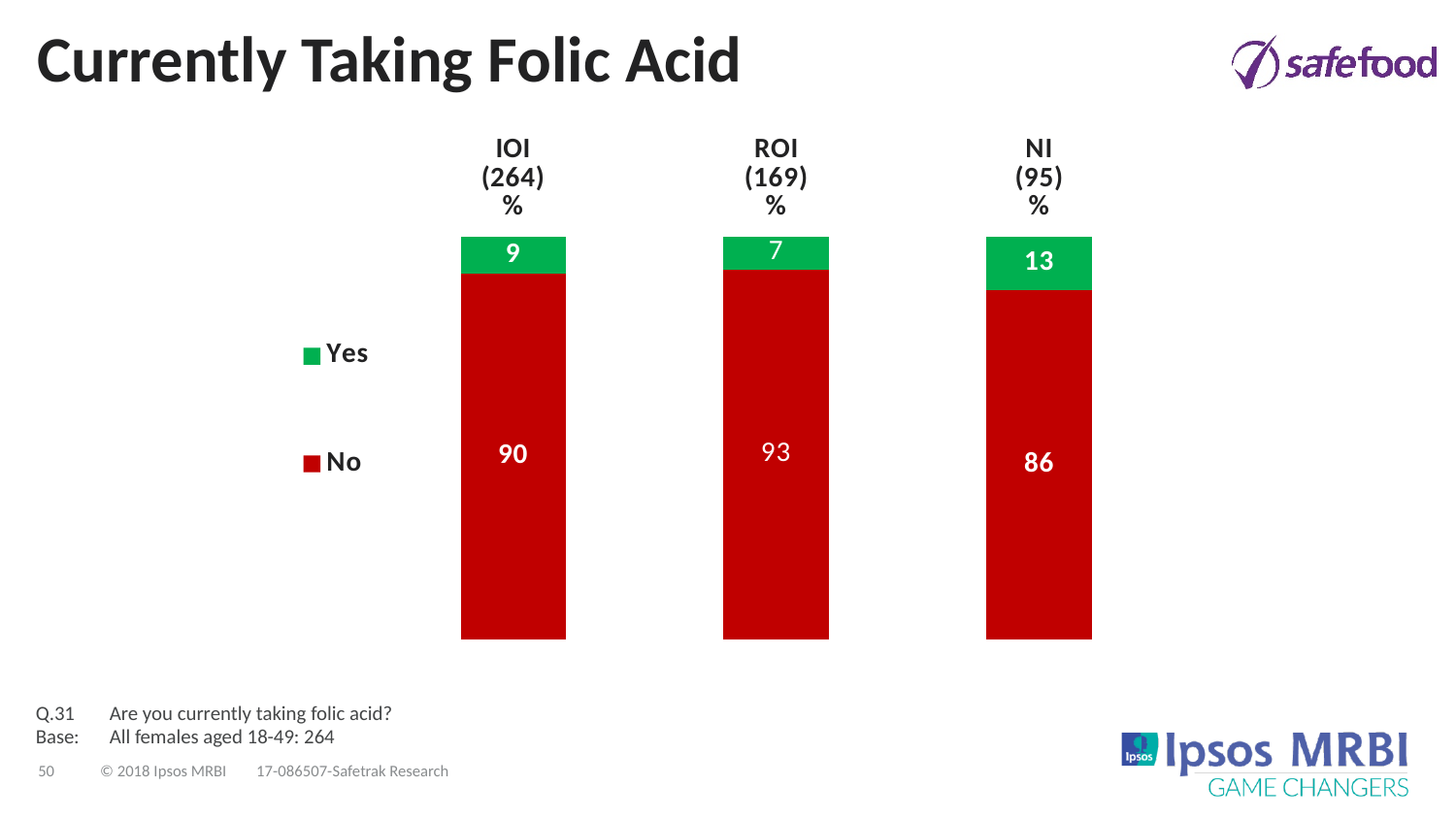
What is the 'No' value for ROI? 93 What is the 'Yes' value for IOI? 9 How many series does the legend list? 2 Which colour represents 'Yes' in the chart? Green What is the 'Yes' value for NI? 13 Which region has the highest 'Yes' value? NI Is the 'Yes' value larger for ROI or for NI? NI What is the difference between the 'No' values for ROI and NI? 7 Which region has the lowest 'No' value? NI How many regions are shown in the chart? 3 What is the total of the stacked bar for IOI? 99 What kind of chart is shown on the slide? Stacked bar chart